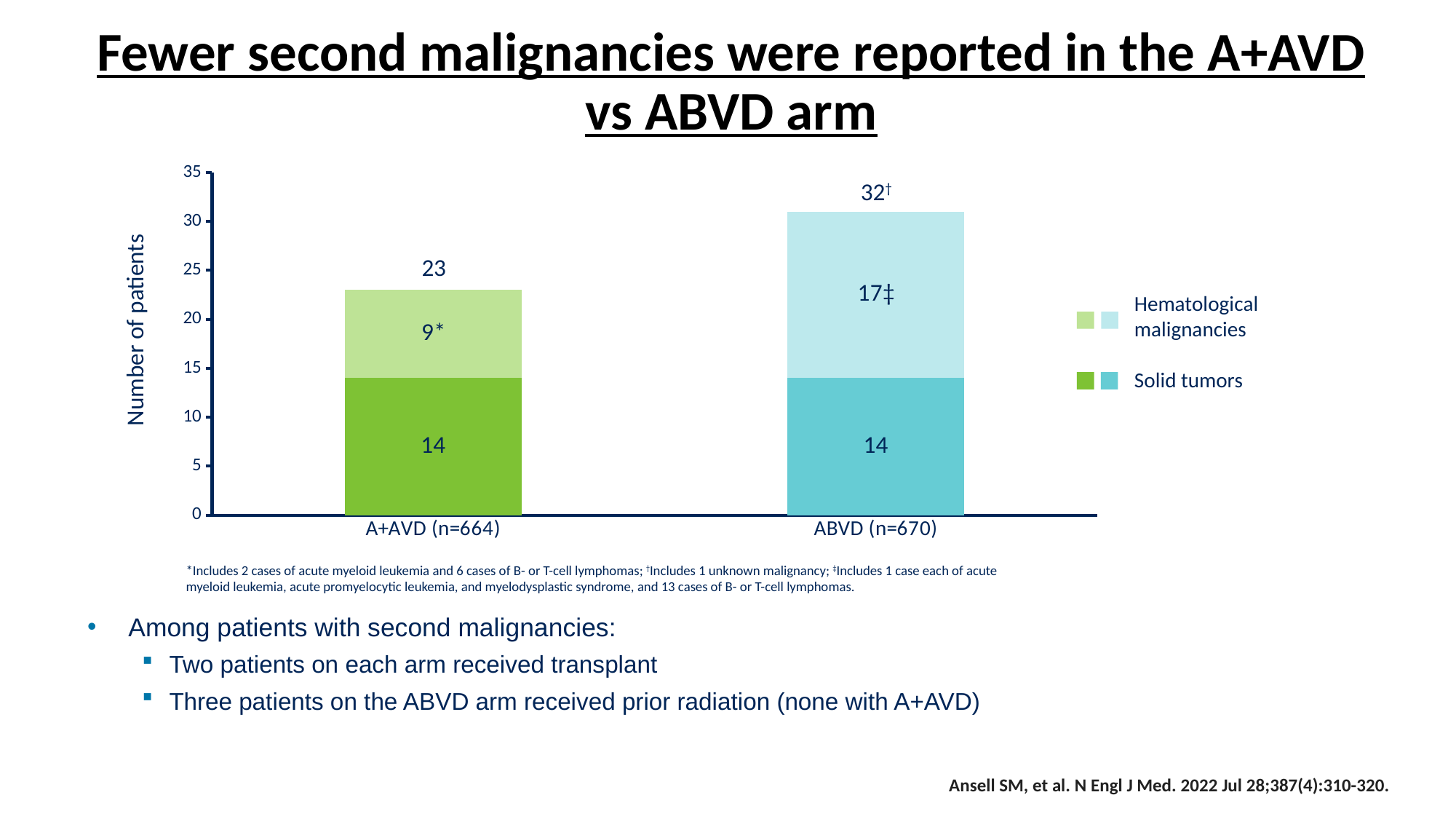
What type of chart is shown on the slide? Stacked bar chart What is the total number of patients with second malignancies shown for the A+AVD (n=664) arm? 23 How many patients with hematological malignancies are shown for the ABVD (n=670) arm? 17 What is the difference in the number of hematological malignancies between the ABVD (n=670) arm and the A+AVD (n=664) arm? 8 Which arm has more patients with hematological malignancies, A+AVD (n=664) or ABVD (n=670)? ABVD (n=670) How many arms (categories) are plotted on the x axis? 2 Which arm has the higher total number of patients with second malignancies? ABVD (n=670) How many patients with solid tumors are shown for the A+AVD (n=664) arm? 14 What is the total number of patients with second malignancies shown for the ABVD (n=670) arm? 32 How many series does the legend list? 2 Is the total for the ABVD (n=670) bar greater or less than 30? greater How many patients with hematological malignancies are shown for the A+AVD (n=664) arm? 9